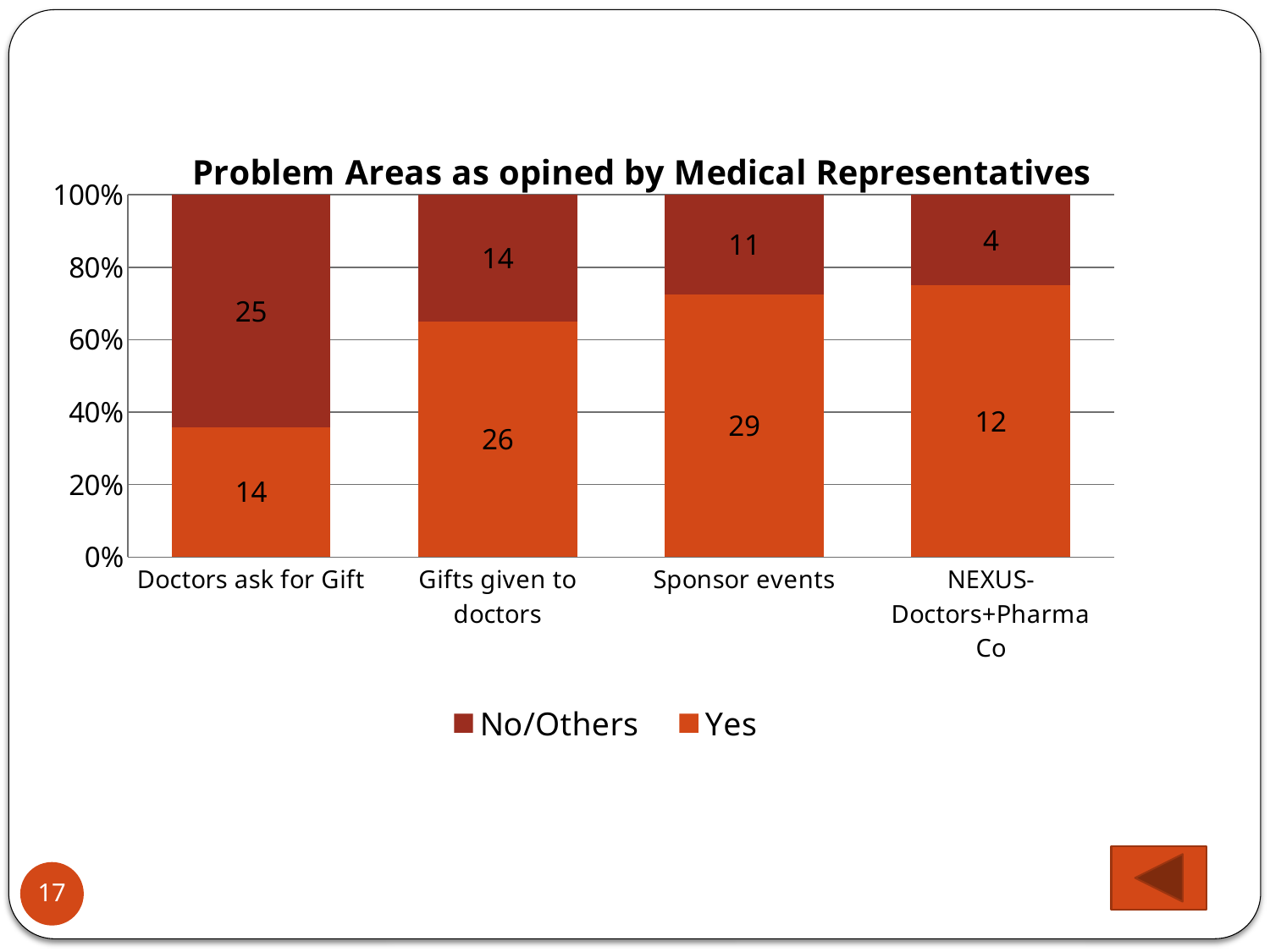
Which is larger for Gifts given to doctors: the 'Yes' value or the 'No/Others' value? Yes What is the total of the stacked bar for Sponsor events? 40 How many categories are shown on the x axis? 4 What is the 'Yes' value for Doctors ask for Gift? 14 How many series does the legend list? 2 What is the difference between the 'Yes' and 'No/Others' values for Doctors ask for Gift? 11 What is the 'Yes' value for NEXUS-Doctors+Pharma Co? 12 Which category has the highest 'Yes' value? Sponsor events What is the title of the chart? Problem Areas as opined by Medical Representatives What kind of chart is shown? Stacked bar chart What is the 'No/Others' value for Sponsor events? 11 Which category has the lowest 'No/Others' value? NEXUS-Doctors+Pharma Co